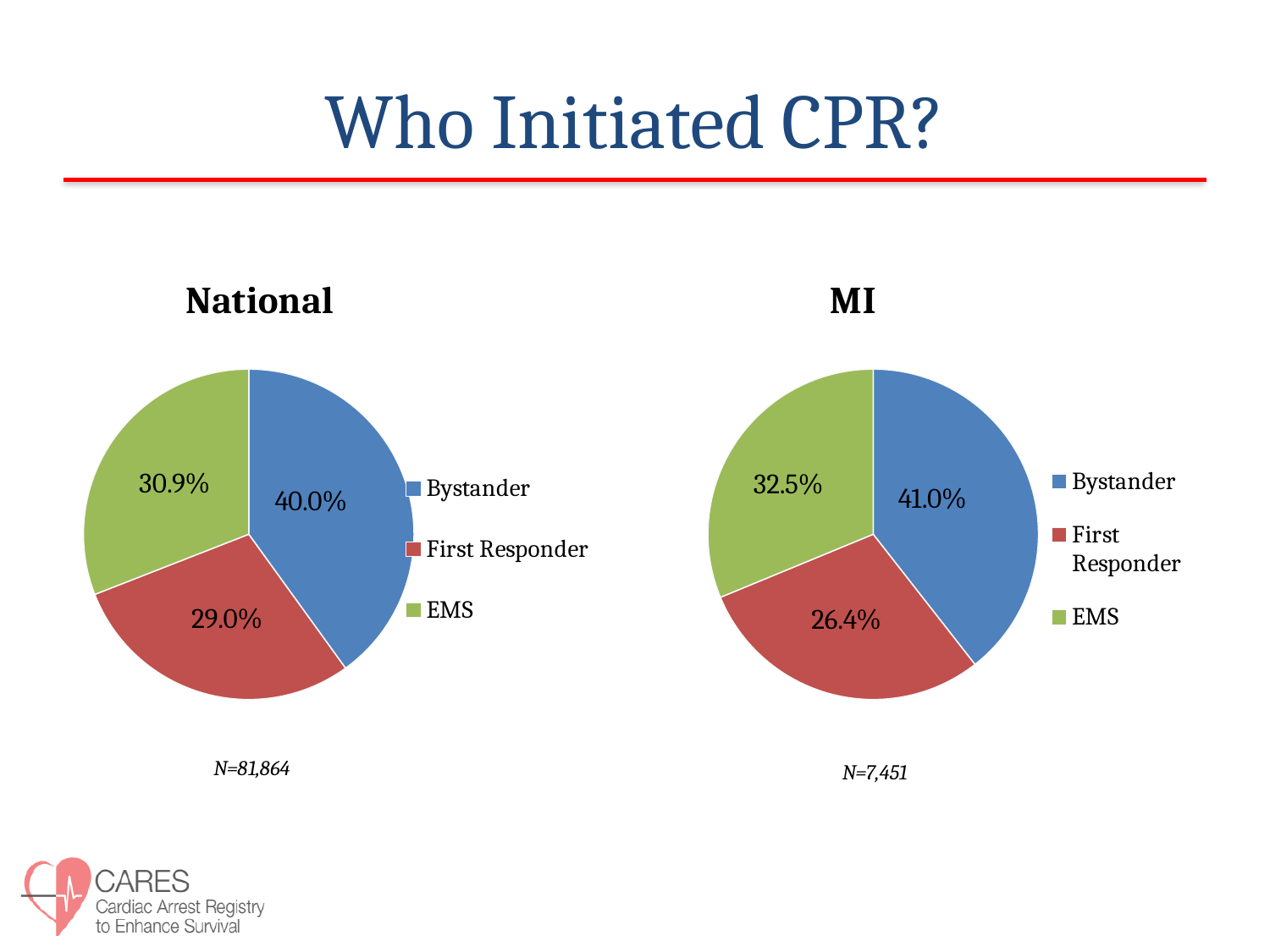
In the MI pie chart, what percentage of CPR was initiated by a First Responder? 26.4% What type of chart is used for the National data? Pie chart In the MI pie chart, which category has the smallest share? First Responder Which is larger: the EMS share in the National chart or the EMS share in the MI chart? MI In the MI pie chart, what percentage of CPR was initiated by EMS? 32.5% What is the N value shown below the MI pie chart? N=7,451 In the National pie chart, what is the difference between the Bystander share and the First Responder share? 11.0% In the National pie chart, what percentage of CPR was initiated by a Bystander? 40.0% How many slices does the MI pie chart have? 3 In the National pie chart, what is the combined share of First Responder and EMS? 59.9% In the MI pie chart, which colour represents EMS? Green In the National pie chart, which category has the largest share? Bystander